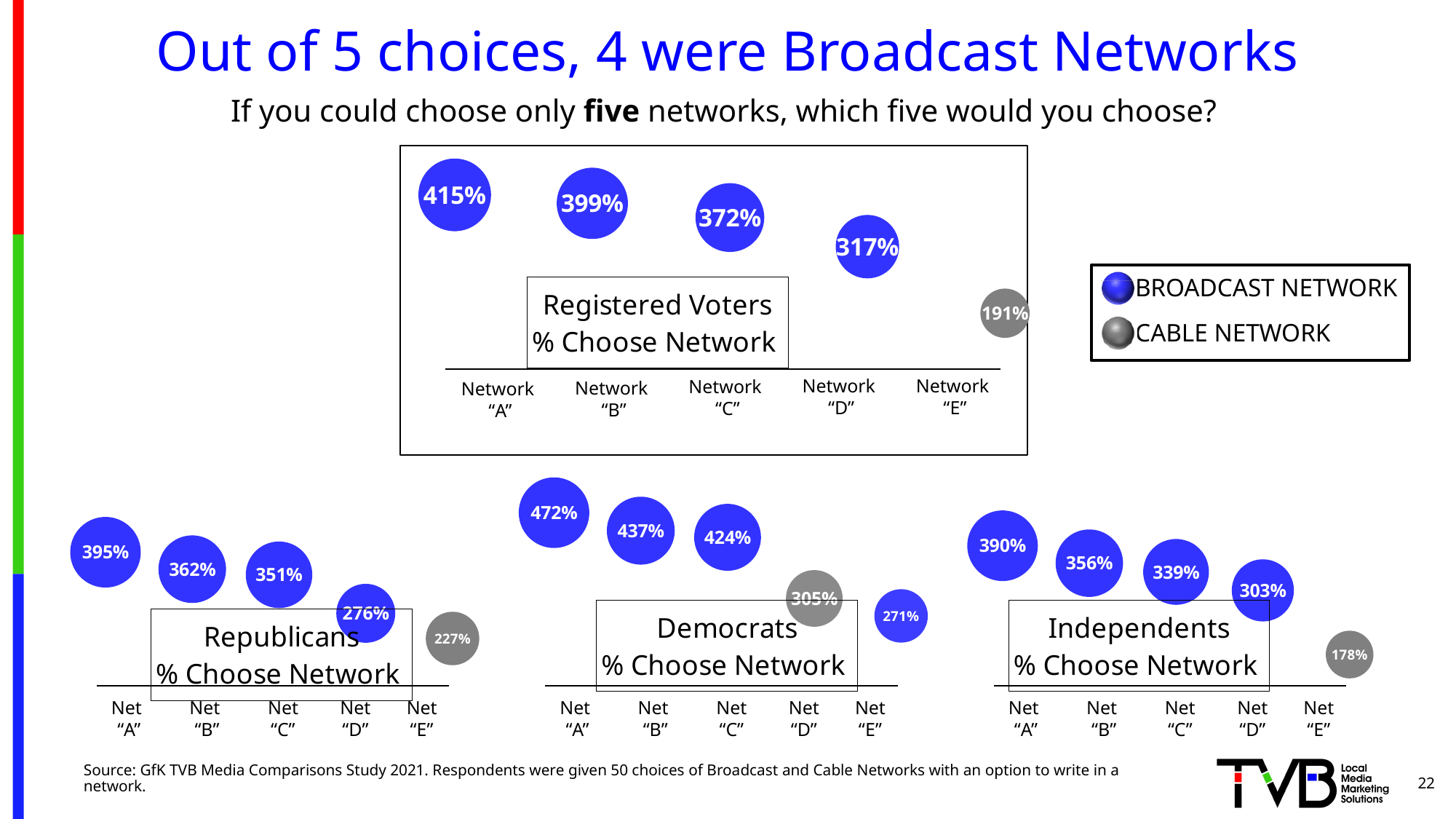
In the Registered Voters chart, which network has the lowest value? Network "E" In the Independents chart, what is the value for Net "E"? 178% In the Democrats chart, what is the difference between Net "B" and Net "C"? 13% In the Registered Voters chart, what is the difference between Network "A" and Network "D"? 98% In the Republicans chart, what is the value for Net "C"? 351% In the Democrats chart, what is the value for Net "A"? 472% In the Independents chart, do the values rise or fall from Net "A" to Net "E"? fall In the Democrats chart, which is larger, the value for Net "D" or Net "E"? Net "D" In the Republicans chart, which network has the highest value? Net "A" How many networks are shown in the Independents chart? 5 In the Registered Voters chart, what is the value for Network "A"? 415% According to the legend, what does a grey bubble represent? Cable Network